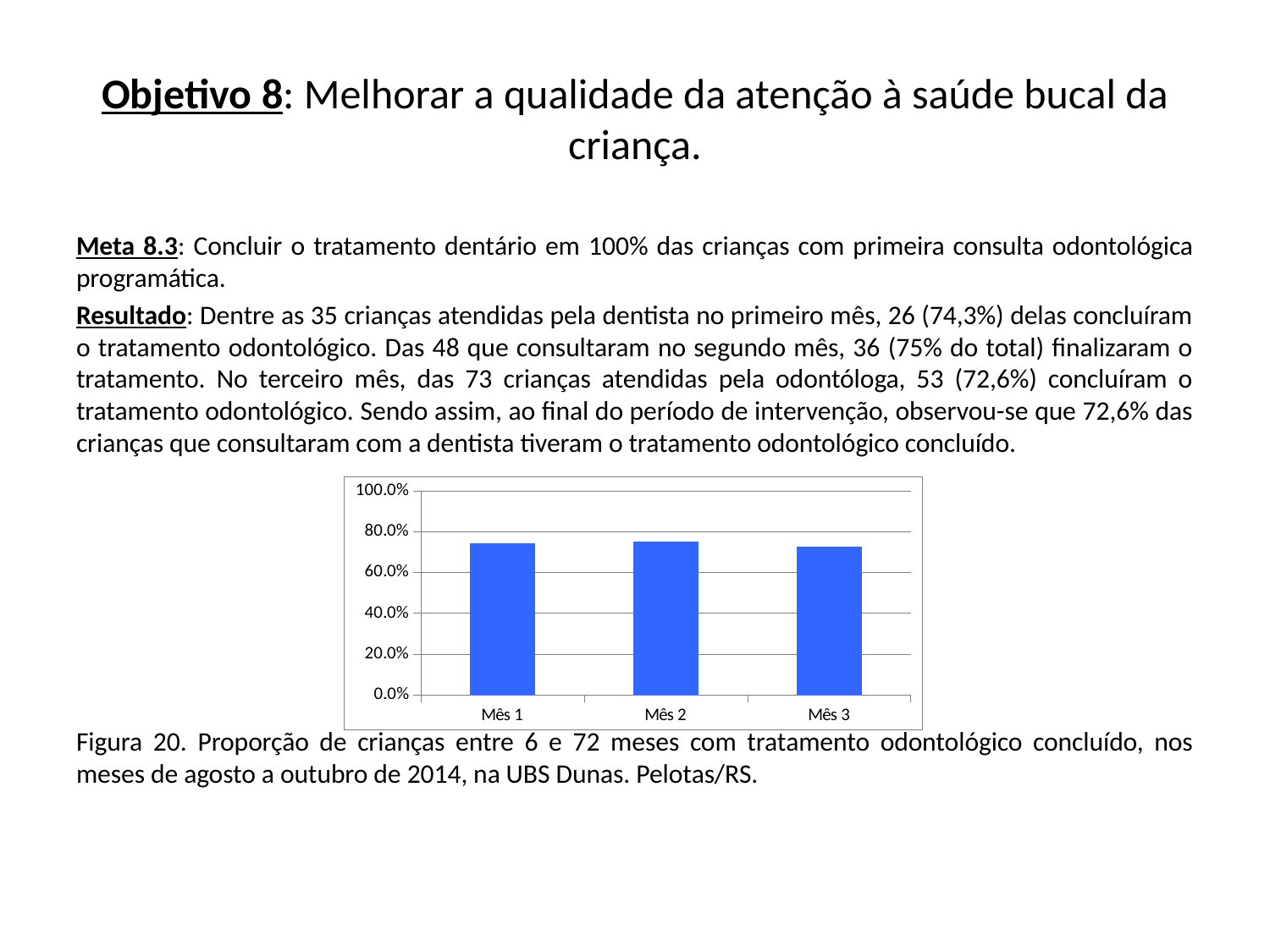
How many bars (categories) are plotted in the chart? 3 Is the value for Mês 1 greater or less than 60.0%? greater What is the highest value shown on the y axis of the chart? 100.0% Is the value for Mês 3 greater or less than 40.0%? greater Is the value for Mês 3 greater or less than 60.0%? greater What kind of chart is shown on the slide? bar chart What is the label of the first category on the x axis? Mês 1